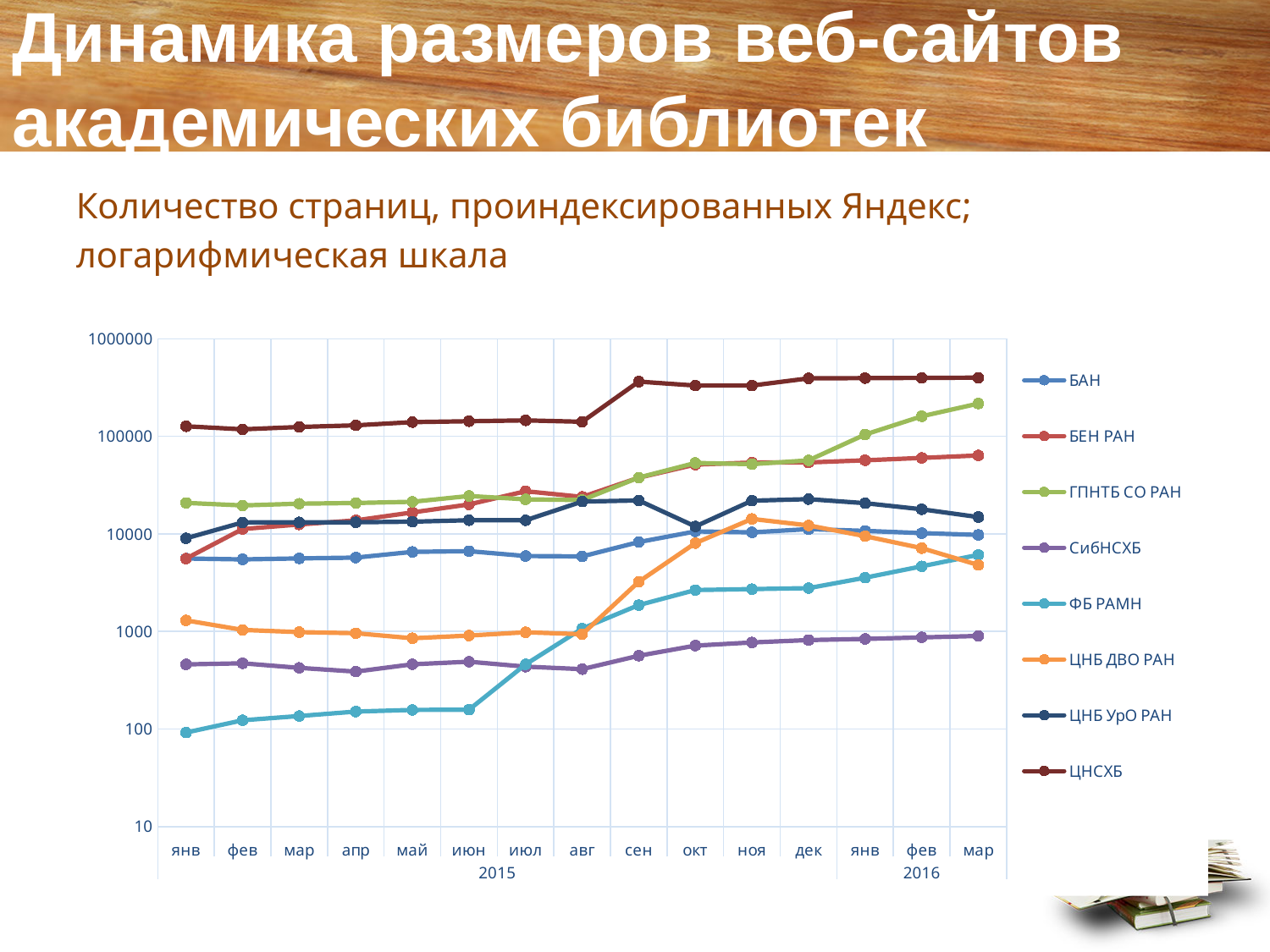
Which series has the lowest value in January 2015? ФБ РАМН What kind of scale does the vertical axis use, according to the slide subtitle? логарифмическая шкала Which series has the highest value in March 2016? ЦНСХБ How many months are plotted along the x axis? 15 What kind of chart is shown on the slide? line chart Is the value for БАН in January 2015 greater or less than 10000? less Is the value for ФБ РАМН in January 2015 greater or less than 1000? less Is the value for ЦНСХБ in March 2016 greater or less than 100000? greater Does the value for ФБ РАМН rise or fall from January 2015 to March 2016? rise In March 2016, which is larger: ГПНТБ СО РАН or БЕН РАН? ГПНТБ СО РАН How many series does the legend list? 8